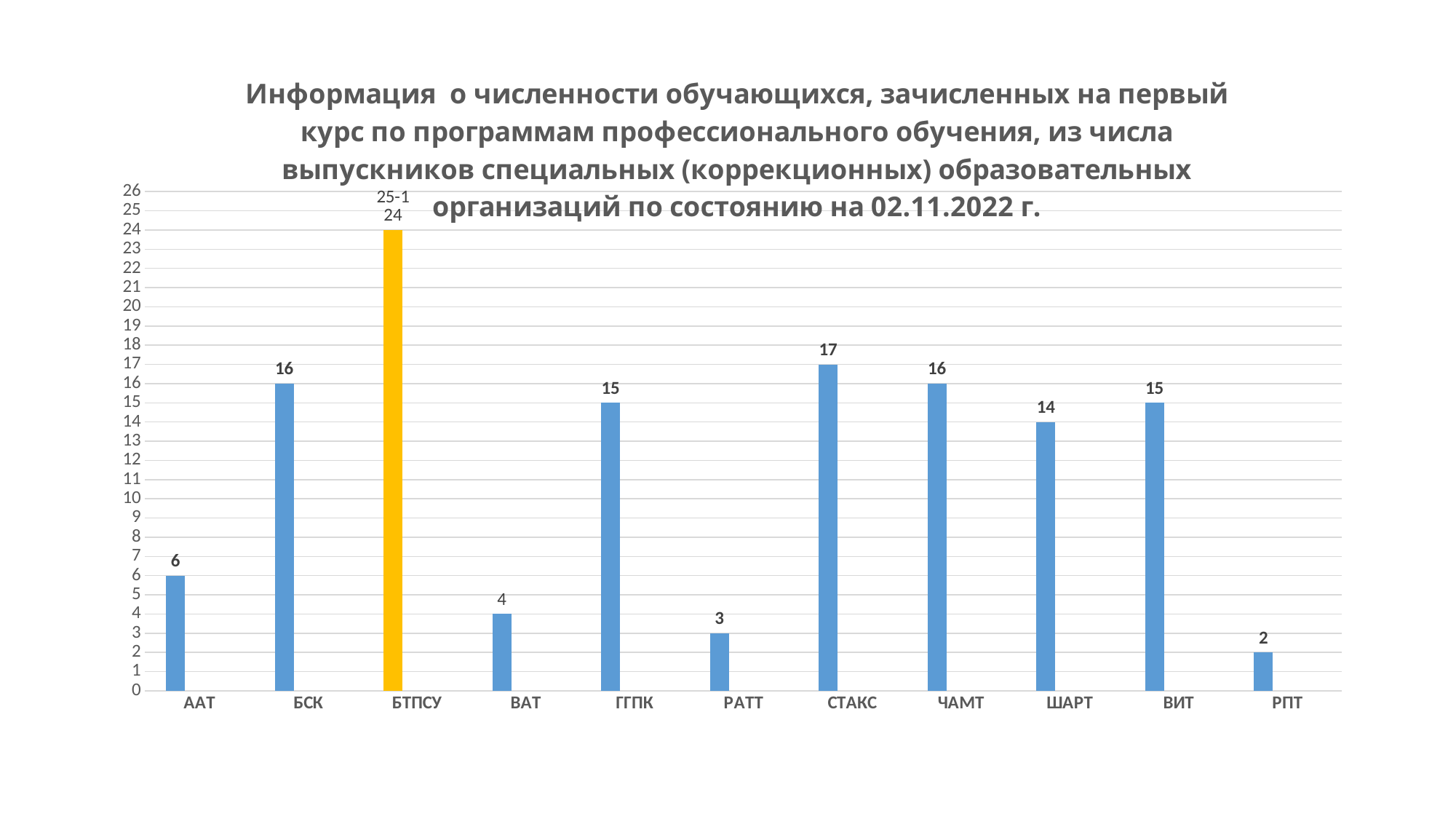
What is the difference between the values for СТАКС and ШАРТ? 3 What is the value for ШАРТ? 14 Which is larger, the value for ГГПК or the value for ЧАМТ? ЧАМТ Which bar is coloured differently (yellow) from the others? БТПСУ What kind of chart is shown on the slide? Bar chart Which category has the highest value? БТПСУ What is the difference between the values for ААТ and ВАТ? 2 How many categories are shown on the x axis? 11 What is the value for РАТТ? 3 Which category has the lowest value? РПТ What is the value for СТАКС? 17 What is the value for БСК? 16